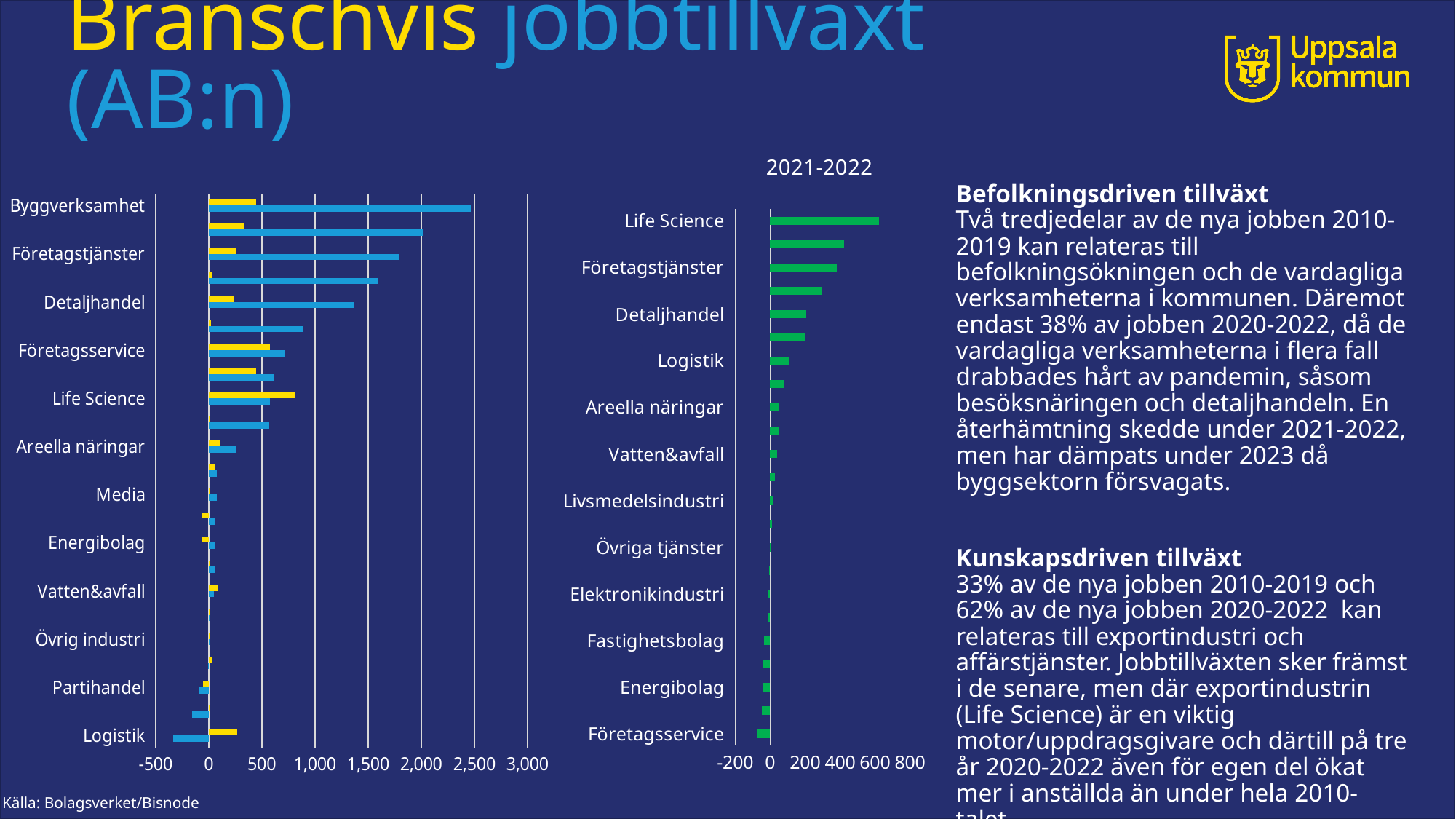
In the chart titled 2021-2022, is the value for Logistik greater or less than 200? less In the chart titled 2021-2022, which category has the highest value? Life Science In the chart titled 2021-2022, which labelled category has the lowest value? Företagsservice In the left chart, is the blue bar for Byggverksamhet greater or less than 2,000? greater What kind of chart is the chart titled 2021-2022? bar chart In the chart titled 2021-2022, is the value for Life Science greater or less than 400? greater In the chart titled 2021-2022, which is larger, the value for Life Science or the value for Logistik? Life Science In the chart titled 2021-2022, do the values rise or fall going from the top category to the bottom category? fall In the left chart, which is larger, the blue bar for Byggverksamhet or the blue bar for Detaljhandel? Byggverksamhet What colour are the bars in the chart titled 2021-2022? green